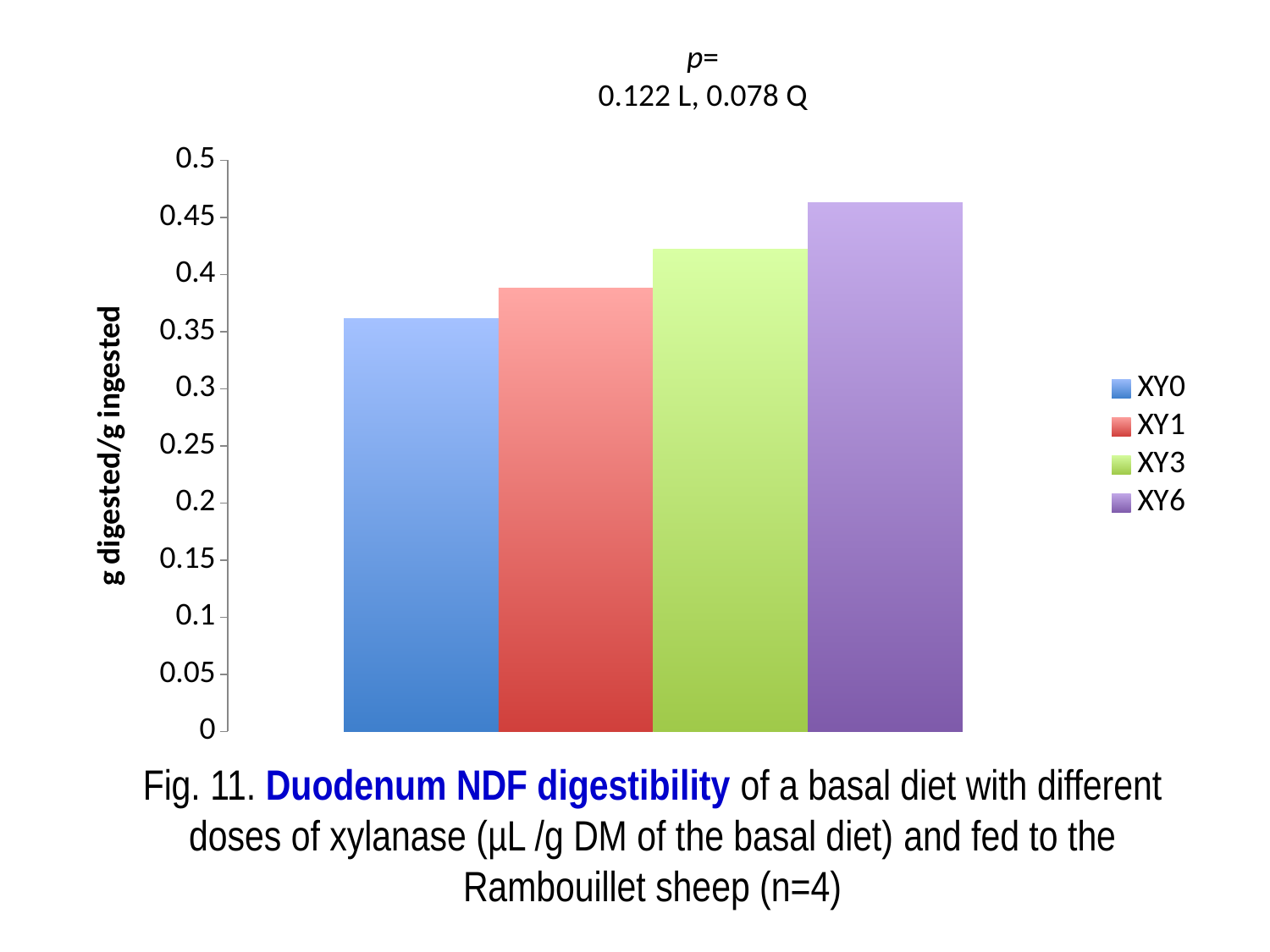
What kind of chart is shown on the slide? bar chart Do the values rise or fall from XY0 to XY6 along the x axis? rise Which treatment has the highest duodenum NDF digestibility? XY6 What is the label on the y axis of the chart? g digested/g ingested Is the value for XY6 greater or less than 0.4? greater Which is larger, the value for XY3 or the value for XY1? XY3 How many bars are plotted in the chart? 4 Which treatment has the lowest duodenum NDF digestibility? XY0 Which is larger, the value for XY0 or the value for XY6? XY6 Is the value for XY0 greater or less than 0.4? less How many entries does the legend list? 4 Is the value for XY3 greater or less than 0.4? greater